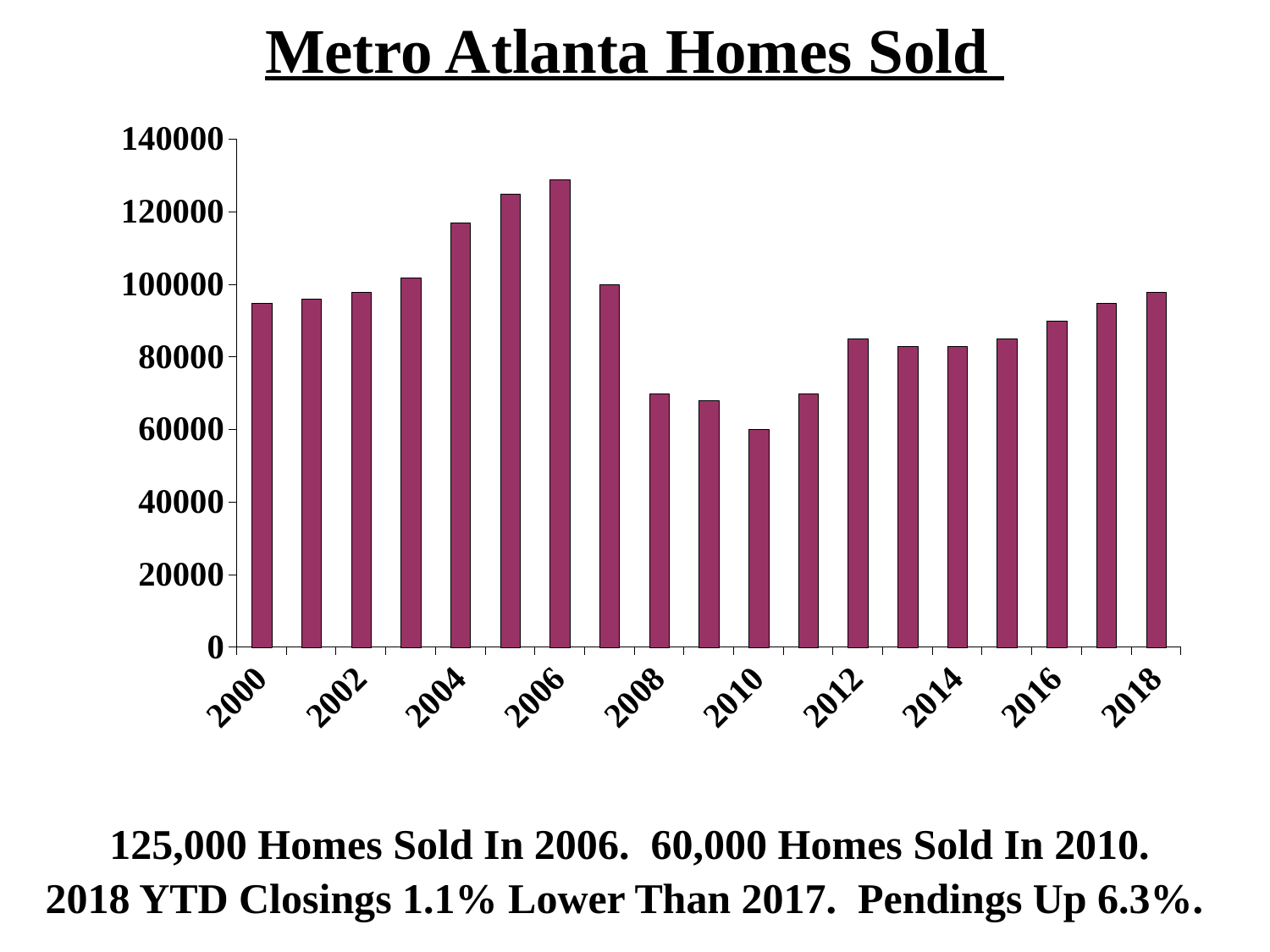
Which year had more homes sold, 2006 or 2007? 2006 What kind of chart is shown on the slide? bar chart Which year has the highest number of homes sold? 2006 How many years (bars) are plotted in the chart? 19 Is the value for 2004 greater or less than 100000? greater Is the value for 2005 greater or less than 120000? greater Which year has the lowest number of homes sold? 2010 Do the values generally rise or fall from 2010 to 2018? rise Do the values rise or fall from 2006 to 2010? fall Is the value for 2000 greater or less than 100000? less What is the title of the chart? Metro Atlanta Homes Sold